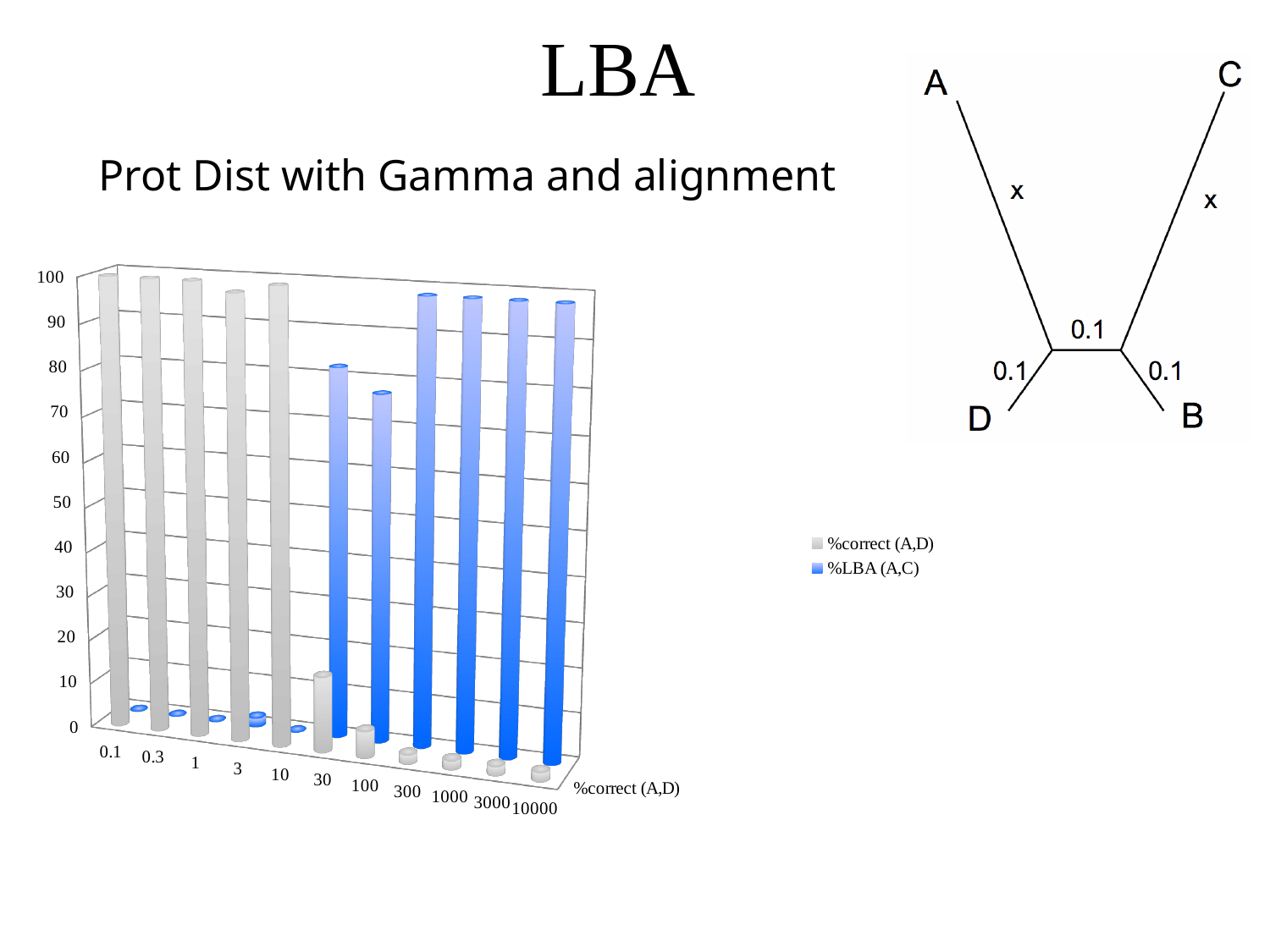
What are the two series named in the chart's legend? %correct (A,D) and %LBA (A,C) What colour are the bars for the %LBA (A,C) series? blue Is the value of %LBA (A,C) at 0.1 greater or less than 10? less Is the value of %correct (A,D) at 0.1 greater or less than 90? greater Is the value of %correct (A,D) at 10000 greater or less than 10? less How many series does the chart's legend list? 2 At category 1000, which series has the larger value, %correct (A,D) or %LBA (A,C)? %LBA (A,C) Do the values of the %correct (A,D) series rise or fall as you move along the x axis from 0.1 to 10000? fall How many categories are shown along the x axis of the chart? 11 What kind of chart is shown on the slide? bar chart